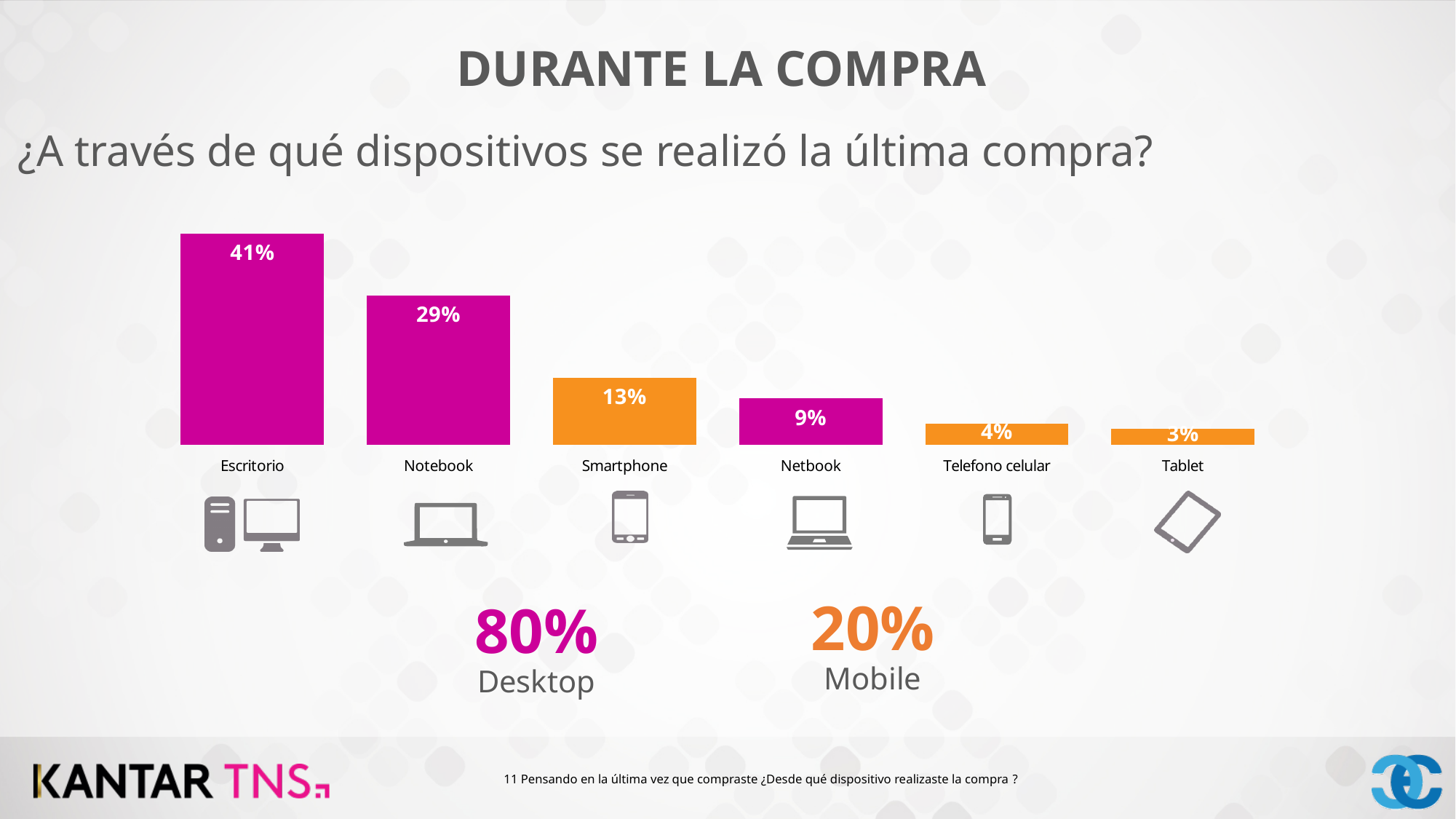
Which device has the lowest share of last purchases? Tablet Which device has the highest share of last purchases? Escritorio Which is larger, the value for Notebook or the value for Netbook? Notebook Do the values rise or fall from left to right across the categories? Fall What is the value shown for Smartphone? 13% What percentage is shown for Mobile below the chart? 20% What is the value shown for Tablet? 3% What is the difference between the values for Escritorio and Notebook? 12% How many device categories are shown in the chart? 6 What kind of chart is shown on the slide? Bar chart What percentage of last purchases were made via Escritorio? 41% What is the difference between the values for Smartphone and Netbook? 4%